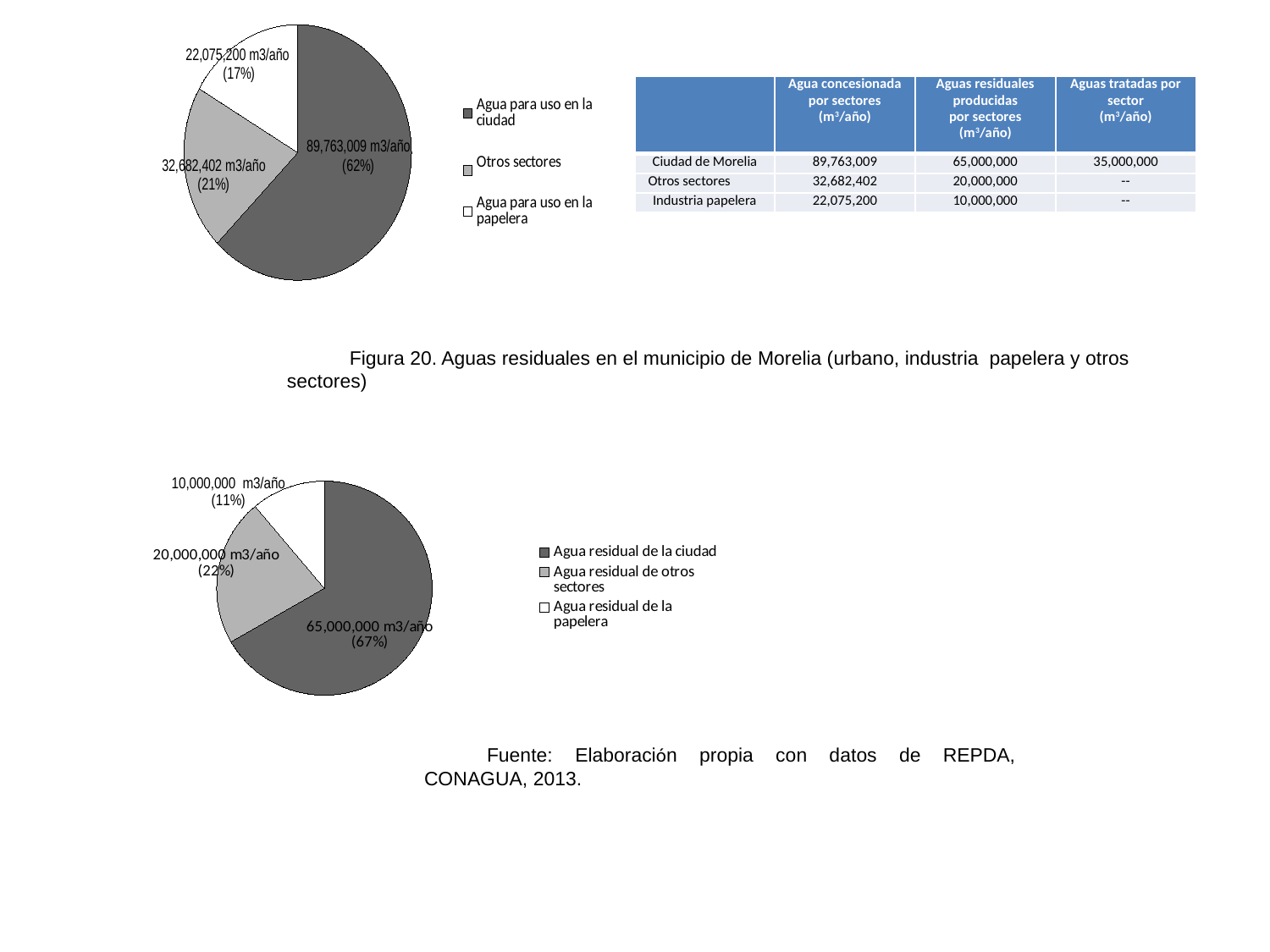
What type of chart is the top chart on the slide? Pie chart In the top pie chart, what value is shown for 'Agua para uso en la ciudad'? 89,763,009 m3/año In the top pie chart, which category has the smallest slice? Agua para uso en la papelera In the bottom pie chart, what share of the pie does 'Agua residual de otros sectores' represent? 22% In the top pie chart, what share of the pie does 'Agua para uso en la papelera' represent? 17% In the top pie chart, which category has the largest slice? Agua para uso en la ciudad How many slices does the top pie chart have? 3 In the bottom pie chart, what value is shown for 'Agua residual de la ciudad'? 65,000,000 m3/año In the top pie chart, what value is shown for 'Otros sectores'? 32,682,402 m3/año In the bottom pie chart, what is the difference between the values for 'Agua residual de otros sectores' and 'Agua residual de la papelera'? 10,000,000 m3/año How many entries does the legend of the bottom pie chart list? 3 In the bottom pie chart, which is larger: 'Agua residual de la ciudad' or 'Agua residual de la papelera'? Agua residual de la ciudad